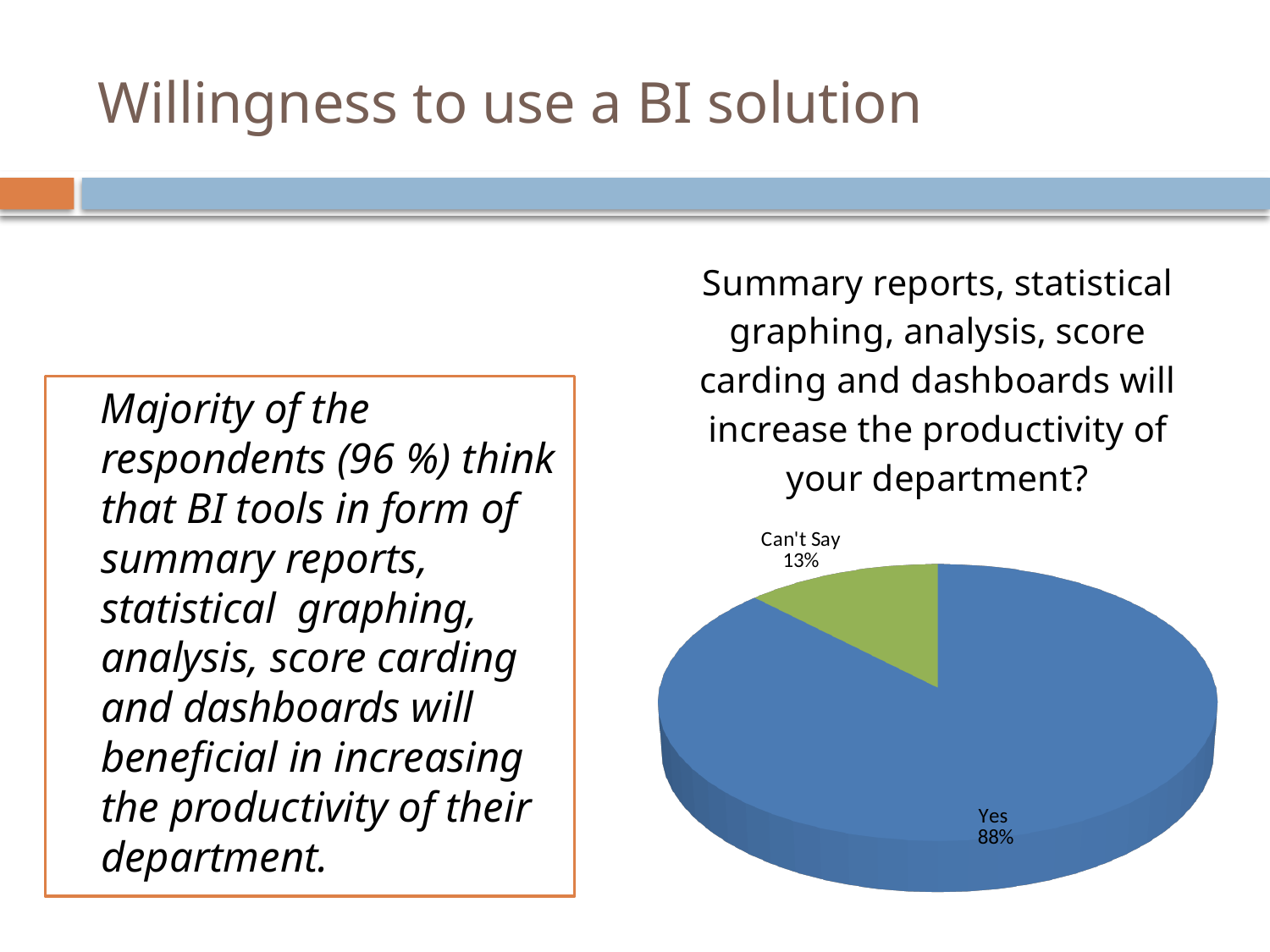
Which slice of the pie chart is the smallest? Can't Say What is the difference in percentage points between the "Yes" and "Can't Say" slices? 75 percentage points What colour is the "Can't Say" slice in the pie chart? Green How many slices does the pie chart have? 2 Which slice of the pie chart is the largest? Yes What percentage of respondents answered "Yes" in the pie chart? 88% What kind of chart is shown on the slide? Pie chart Which is larger in the pie chart, the "Yes" slice or the "Can't Say" slice? Yes What is the title of the pie chart? Summary reports, statistical graphing, analysis, score carding and dashboards will increase the productivity of your department? What percentage of respondents answered "Can't Say" in the pie chart? 13% What share of the pie does the "Yes" slice represent? 88%